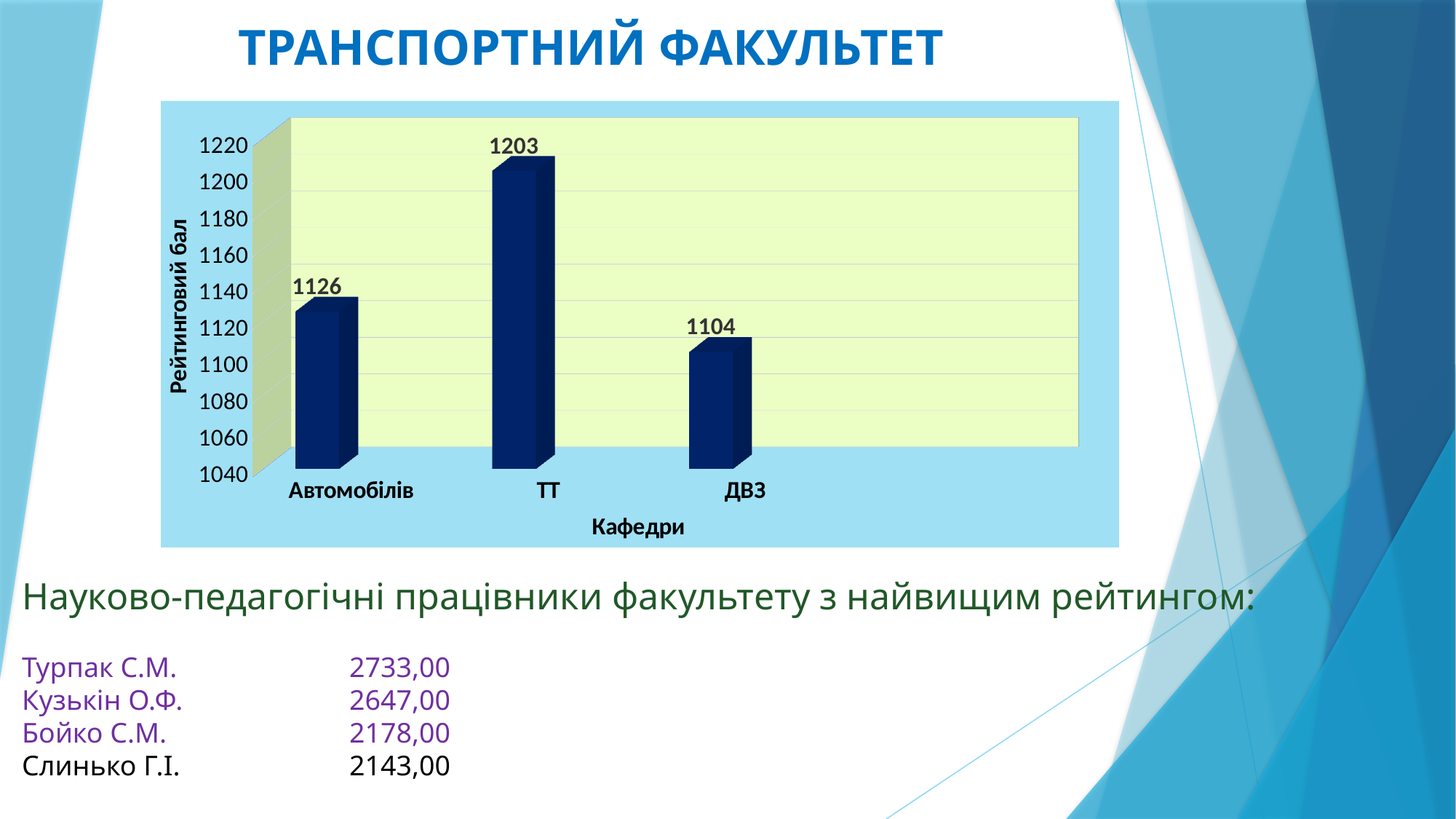
What is the rating score for the ТТ department? 1203 What is the rating score for the ДВЗ department? 1104 What is the difference between the rating scores of ТТ and Автомобілів? 77 Which has a higher rating score, Автомобілів or ДВЗ? Автомобілів What is the difference between the rating scores of Автомобілів and ДВЗ? 22 How many departments are shown on the chart? 3 Which department has the highest rating score? ТТ Is the value for ТТ greater or less than 1200? greater What is the label of the x axis of the chart? Кафедри What kind of chart is shown on the slide? bar chart What is the rating score (Рейтинговий бал) for the Автомобілів department? 1126 Which department has the lowest rating score? ДВЗ